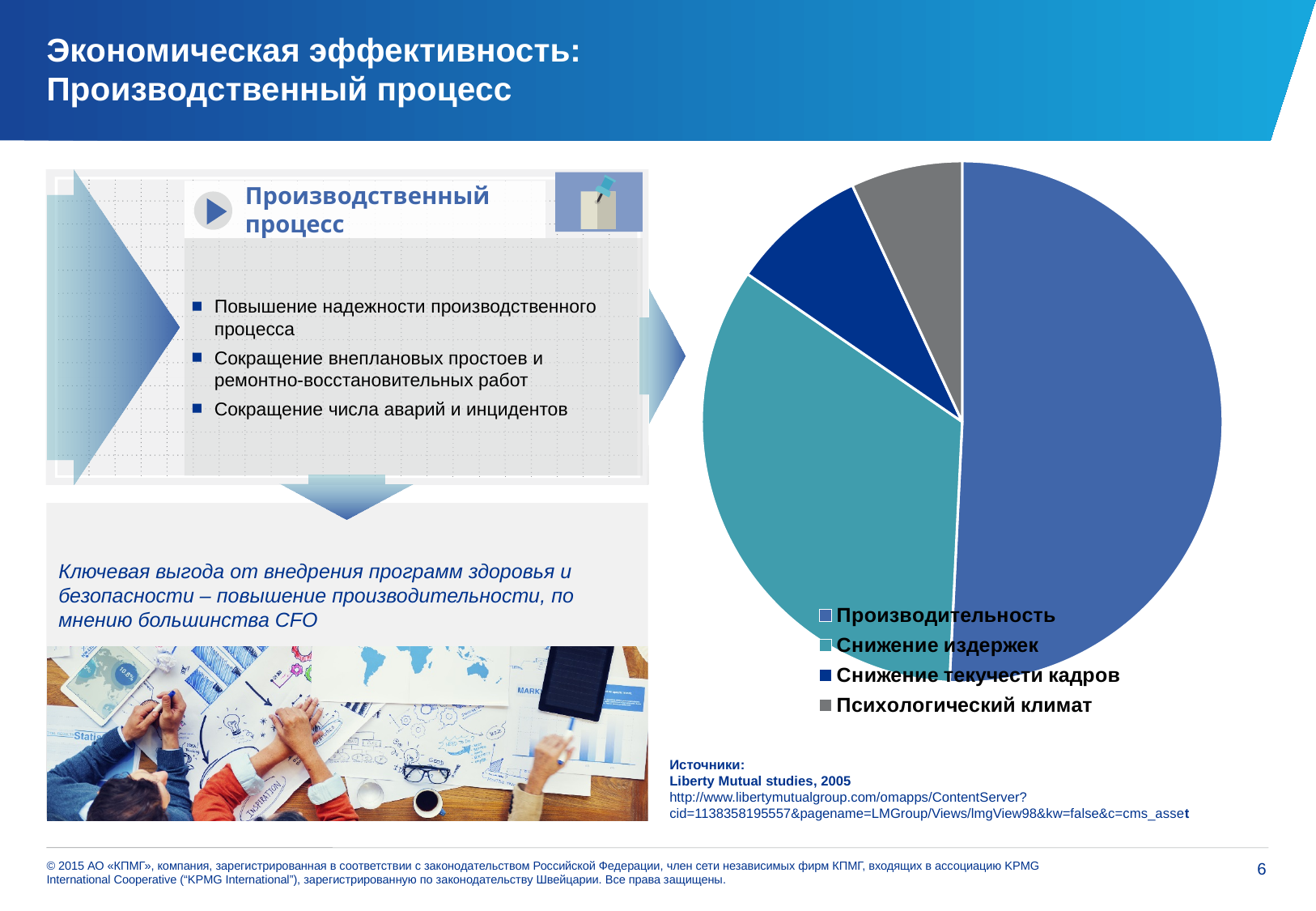
Which category has the largest slice in the pie chart? Производительность What kind of chart is shown on the slide? pie chart How many entries does the legend of the pie chart list? 4 Which slice is larger in the pie chart: Снижение издержек or Снижение текучести кадров? Снижение издержек How many slices does the pie chart have? 4 What is the first entry listed in the pie chart's legend? Производительность Which slice is larger in the pie chart: Снижение издержек or Психологический климат? Снижение издержек What colour is the slice for Психологический климат in the pie chart? grey Which category has the smallest slice in the pie chart? Психологический климат Which slice is larger in the pie chart: Производительность or Снижение издержек? Производительность Which category is the second largest slice in the pie chart? Снижение издержек